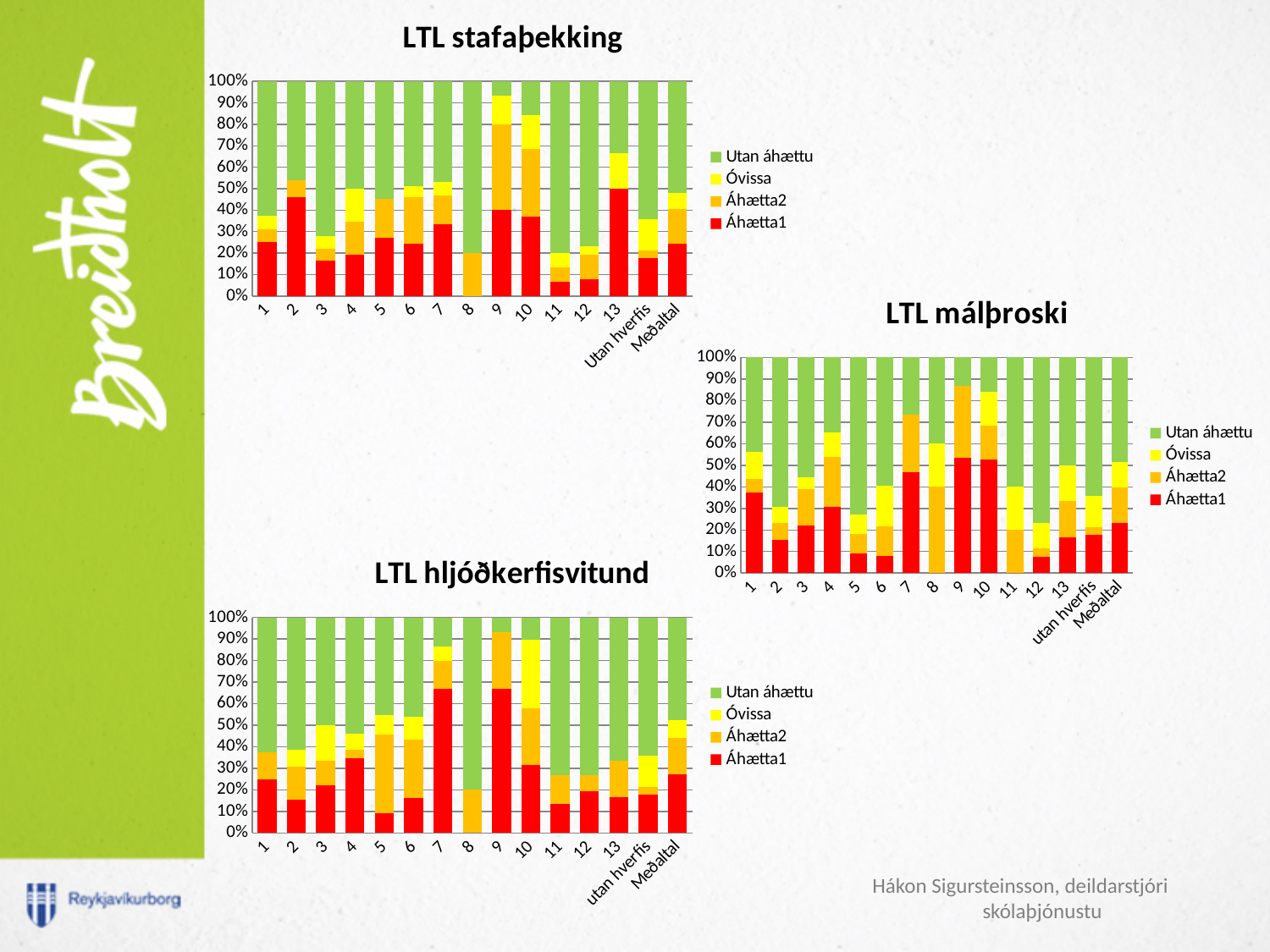
What kind of chart is the 'LTL stafaþekking' chart? stacked bar chart In the 'LTL stafaþekking' chart, is the Áhætta1 value for category 13 greater or less than 40%? greater Which legend entry is shown in green in the 'LTL málþroski' chart? Utan áhættu In the 'LTL hljóðkerfisvitund' chart, is the Áhætta1 value for category 7 greater or less than 60%? greater How many categories are shown on the x axis of the 'LTL hljóðkerfisvitund' chart? 15 In the 'LTL hljóðkerfisvitund' chart, which has the larger Áhætta1 value, category 9 or category 5? 9 How many series does the legend of the 'LTL málþroski' chart list? 4 In the 'LTL hljóðkerfisvitund' chart, which category has the lowest Áhætta1 value? 8 In the 'LTL stafaþekking' chart, which has the larger Áhætta1 value, category 2 or category 3? 2 In the 'LTL stafaþekking' chart, which category has the lowest Áhætta1 value? 8 In the 'LTL stafaþekking' chart, is the Áhætta1 value for category 3 greater or less than 20%? less